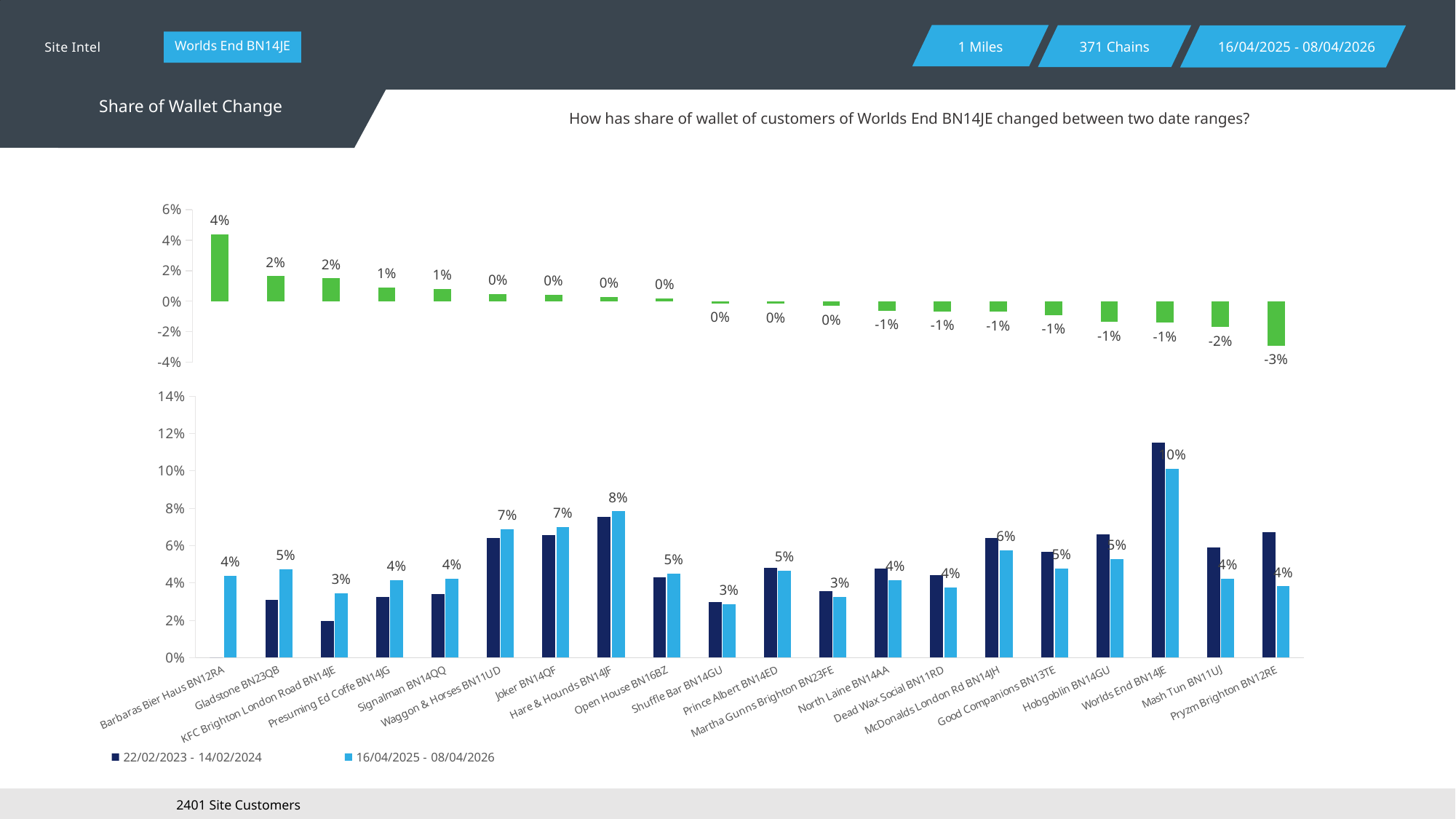
In the top chart, which category has the highest share of wallet change? Barbaras Bier Haus BN12RA In the top chart, what is the share of wallet change for Gladstone BN23QB? 2% How many categories are shown on the x axis of the bottom chart? 20 In the bottom chart, what is the value for Worlds End BN14JE in the 16/04/2025 - 08/04/2026 series? 10% How many series does the legend of the bottom chart list? 2 What kind of chart is the top chart on the slide? bar chart In the top chart, which category has the lowest share of wallet change? Pryzm Brighton BN12RE In the bottom chart, is the value for Worlds End BN14JE in the 22/02/2023 - 14/02/2024 series greater or less than 10%? greater In the bottom chart, which has the larger value in the 16/04/2025 - 08/04/2026 series: Hare & Hounds BN14JF or Shuffle Bar BN14GU? Hare & Hounds BN14JF In the top chart, what is the share of wallet change for Mash Tun BN11UJ? -2% In the bottom chart, what is the difference between the 16/04/2025 - 08/04/2026 values for Worlds End BN14JE and Hare & Hounds BN14JF? 2% In the bottom chart, what is the value for Hare & Hounds BN14JF in the 16/04/2025 - 08/04/2026 series? 8%